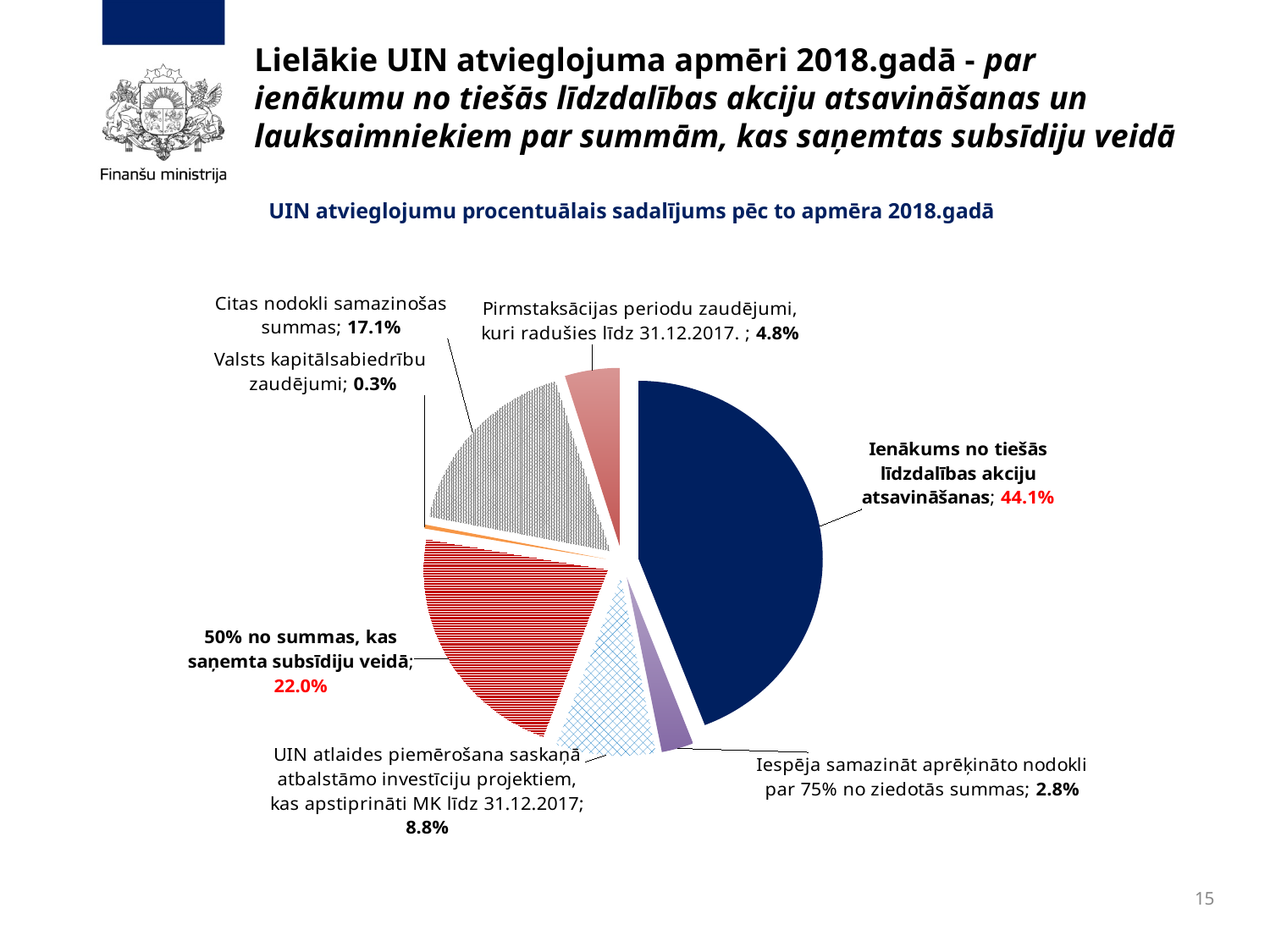
What share of the pie is "Ienākums no tiešās līdzdalības akciju atsavināšanas"? 44.1% What kind of chart is shown on the slide? pie chart How many slices does the pie chart have? 7 What is the value shown for "Valsts kapitālsabiedrību zaudējumi"? 0.3% What is the difference between the share for "Ienākums no tiešās līdzdalības akciju atsavināšanas" and the share for "50% no summas, kas saņemta subsīdiju veidā"? 22.1% What is the value shown for "Pirmstaksācijas periodu zaudējumi, kuri radušies līdz 31.12.2017."? 4.8% What share of the pie is "50% no summas, kas saņemta subsīdiju veidā"? 22.0% What is the value shown for "Citas nodokli samazinošas summas"? 17.1% Which is larger: the share for "UIN atlaides piemērošana saskaņā atbalstāmo investīciju projektiem, kas apstiprināti MK līdz 31.12.2017" or the share for "Iespēja samazināt aprēķināto nodokli par 75% no ziedotās summas"? UIN atlaides piemērošana saskaņā atbalstāmo investīciju projektiem, kas apstiprināti MK līdz 31.12.2017 Which category has the largest share of the pie? Ienākums no tiešās līdzdalības akciju atsavināšanas Which category has the smallest share of the pie? Valsts kapitālsabiedrību zaudējumi What is the title of the chart? UIN atvieglojumu procentuālais sadalījums pēc to apmēra 2018.gadā